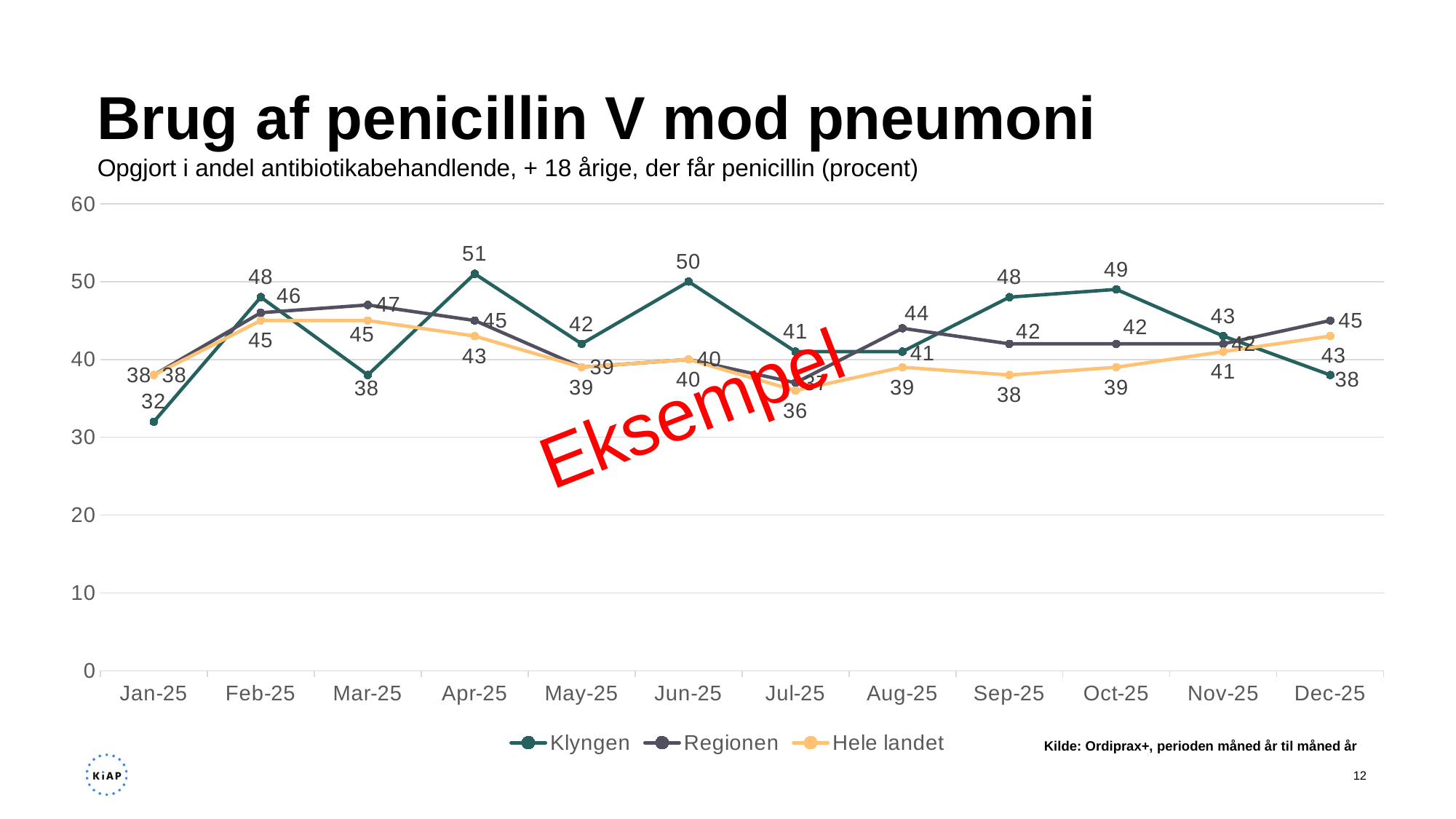
In Dec-25, which is higher: Regionen or Klyngen? Regionen Is the value for Klyngen in Jan-25 greater or less than 40? less In Jun-25, how much higher is Klyngen than Hele landet? 10 What is the value for Hele landet in Dec-25? 43 What is the title of the chart? Brug af penicillin V mod pneumoni In which month does Klyngen reach its highest value? Apr-25 What kind of chart is shown on the slide? Line chart How many series does the legend list? 3 How many months are plotted along the x axis? 12 In which month does Klyngen have its lowest value? Jan-25 What is the value for Klyngen in Apr-25? 51 What is the value for Regionen in Aug-25? 44